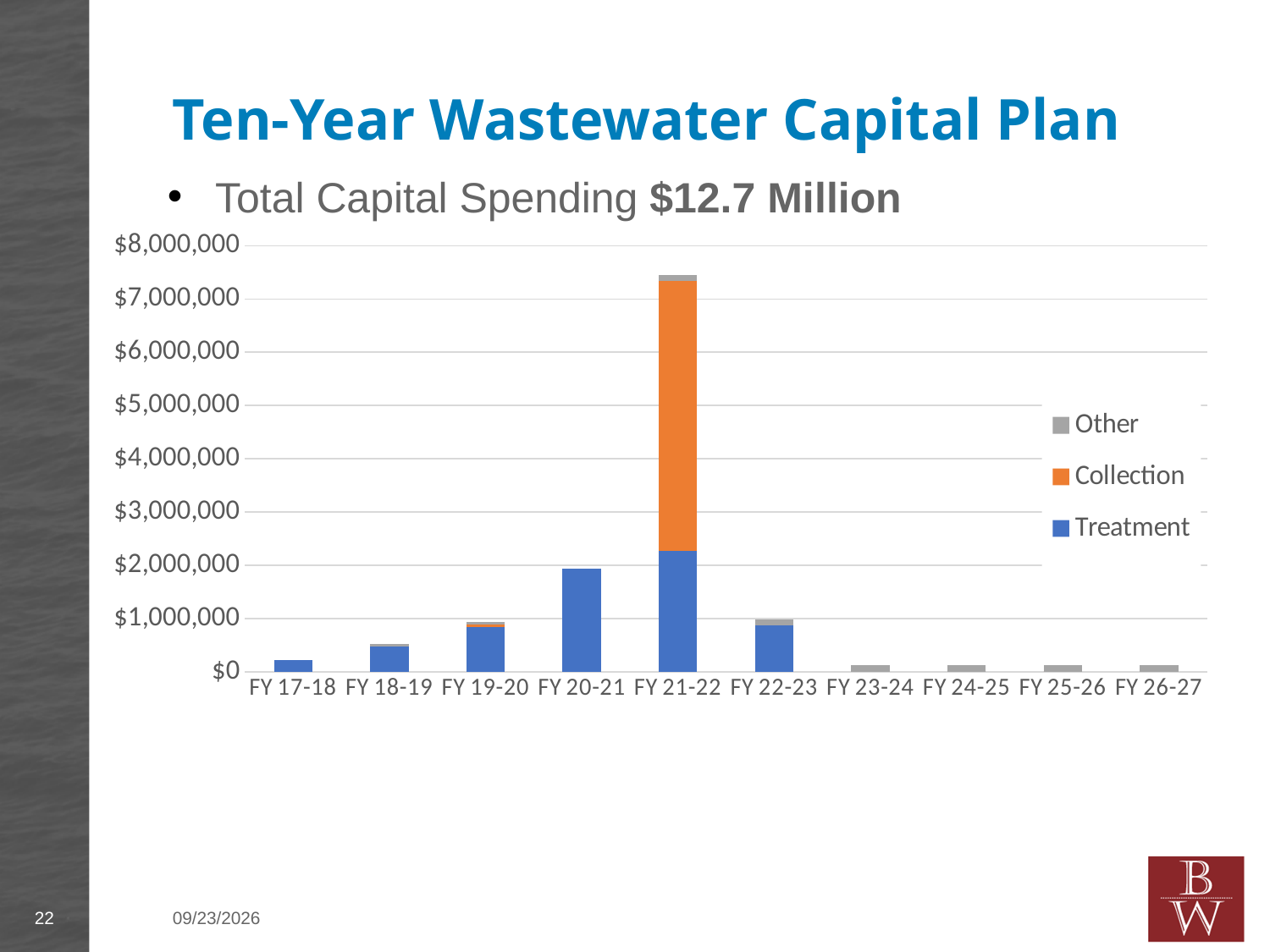
Which is larger, the total for FY 20-21 or the total for FY 19-20? FY 20-21 Is the value for FY 18-19 greater or less than $1,000,000? less Is the total value for FY 21-22 greater or less than $7,000,000? greater Which series is shown in orange in the chart's legend? Collection Is the value for FY 17-18 greater or less than $1,000,000? less How many fiscal years are shown on the x axis of the chart? 10 What total capital spending amount is stated in the bullet above the chart? $12.7 Million Which is larger, the total for FY 21-22 or the total for FY 22-23? FY 21-22 How many series does the chart's legend list? 3 Which fiscal year has the highest total capital spending in the chart? FY 21-22 What kind of chart is shown on the slide? Stacked bar chart